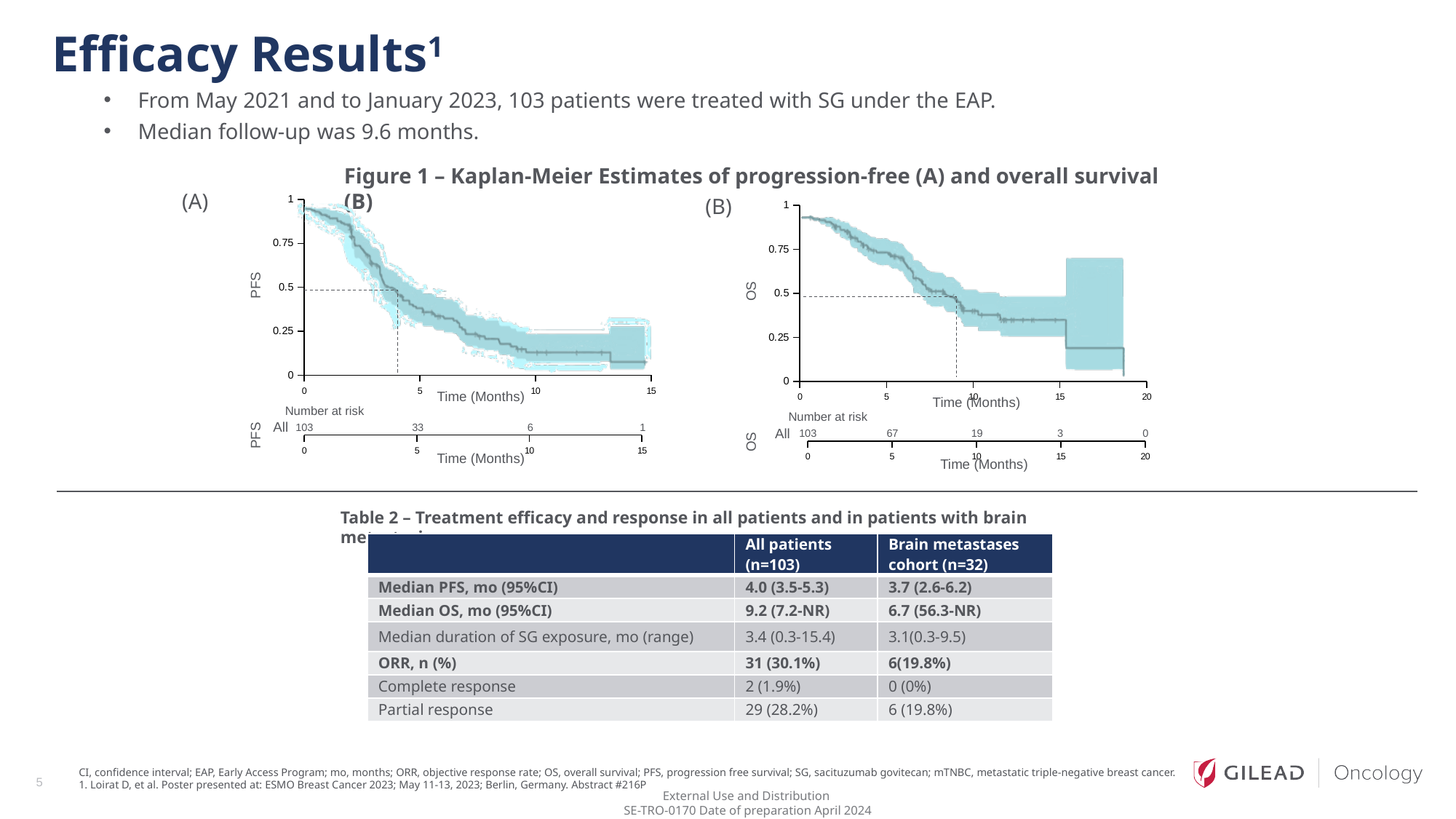
In panel (A), the PFS Kaplan-Meier chart, what is the number at risk at 0 months? 103 In panel (B), the OS chart, what is the number at risk at 10 months? 19 What kind of chart is shown in panel (A)? Kaplan-Meier survival curve (line chart) In panel (B), the OS Kaplan-Meier chart, what is the number at risk at 5 months? 67 In panel (B), the OS chart, what is the number at risk at 20 months? 0 In panel (B), the OS chart, does the survival curve rise or fall as time increases? fall At 10 months, which chart shows more patients at risk: panel (A) PFS or panel (B) OS? Panel (B) OS In panel (B), the OS chart, is the survival probability at 5 months greater or less than 0.5? greater In panel (A), the PFS chart, is the survival probability at 10 months greater or less than 0.25? less In panel (A), the PFS chart, what is the number at risk at 15 months? 1 In panel (A), the PFS chart, what is the difference between the number at risk at 0 months and at 5 months? 70 In panel (A), the PFS chart, what is the number at risk at 5 months? 33